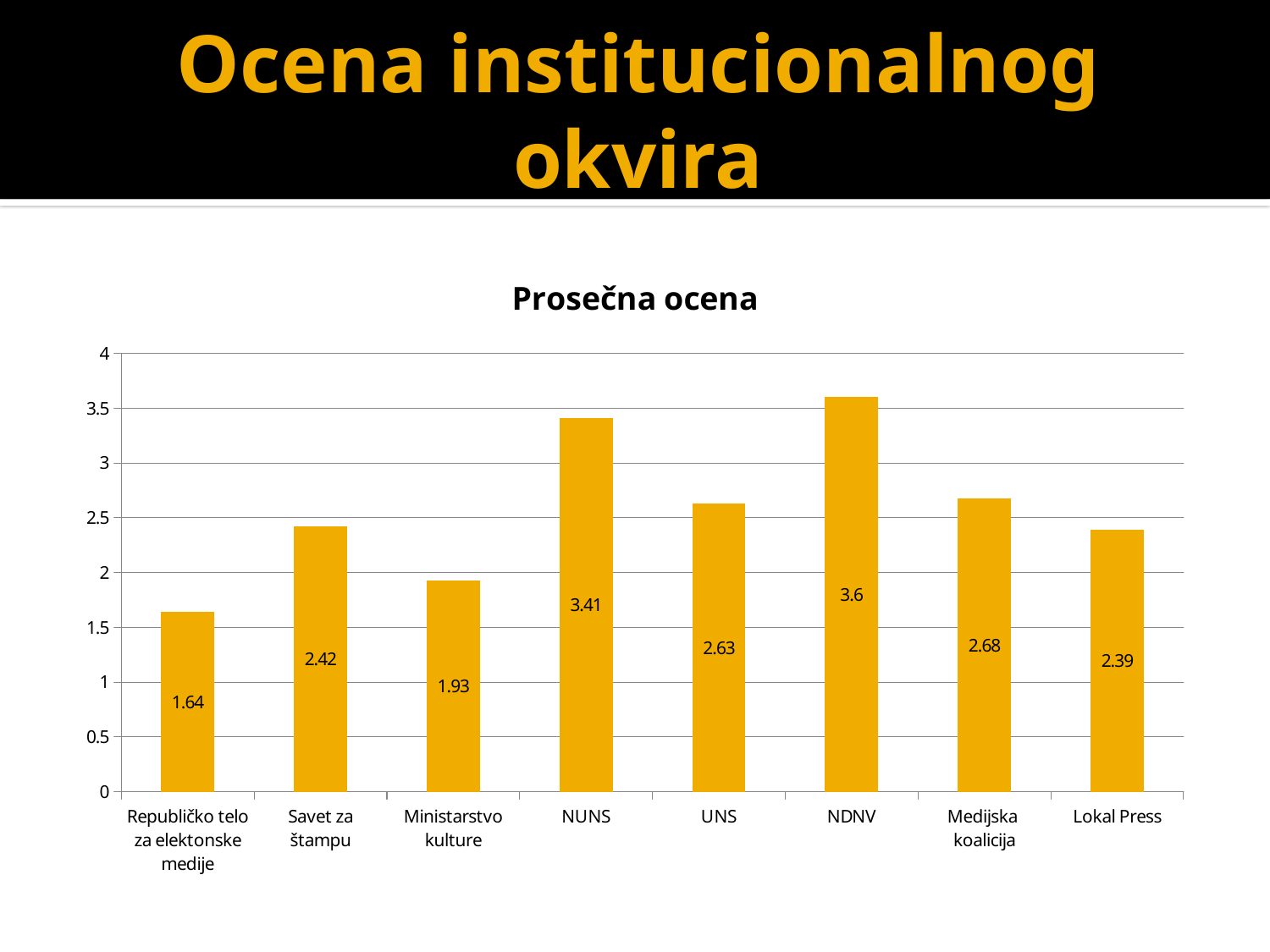
How many categories are shown on the x axis? 8 What kind of chart is shown? bar chart What is the difference between the values for NDNV and NUNS? 0.19 What is the difference between the values for Savet za štampu and Lokal Press? 0.03 Which category has the lowest value? Republičko telo za elektonske medije What is the value for NUNS? 3.41 What is the title of the chart? Prosečna ocena Which category has the highest value? NDNV What is the value for Republičko telo za elektonske medije? 1.64 Which is larger, the value for UNS or the value for Lokal Press? UNS What is the value for Medijska koalicija? 2.68 Is the value for Ministarstvo kulture greater or less than 2? less